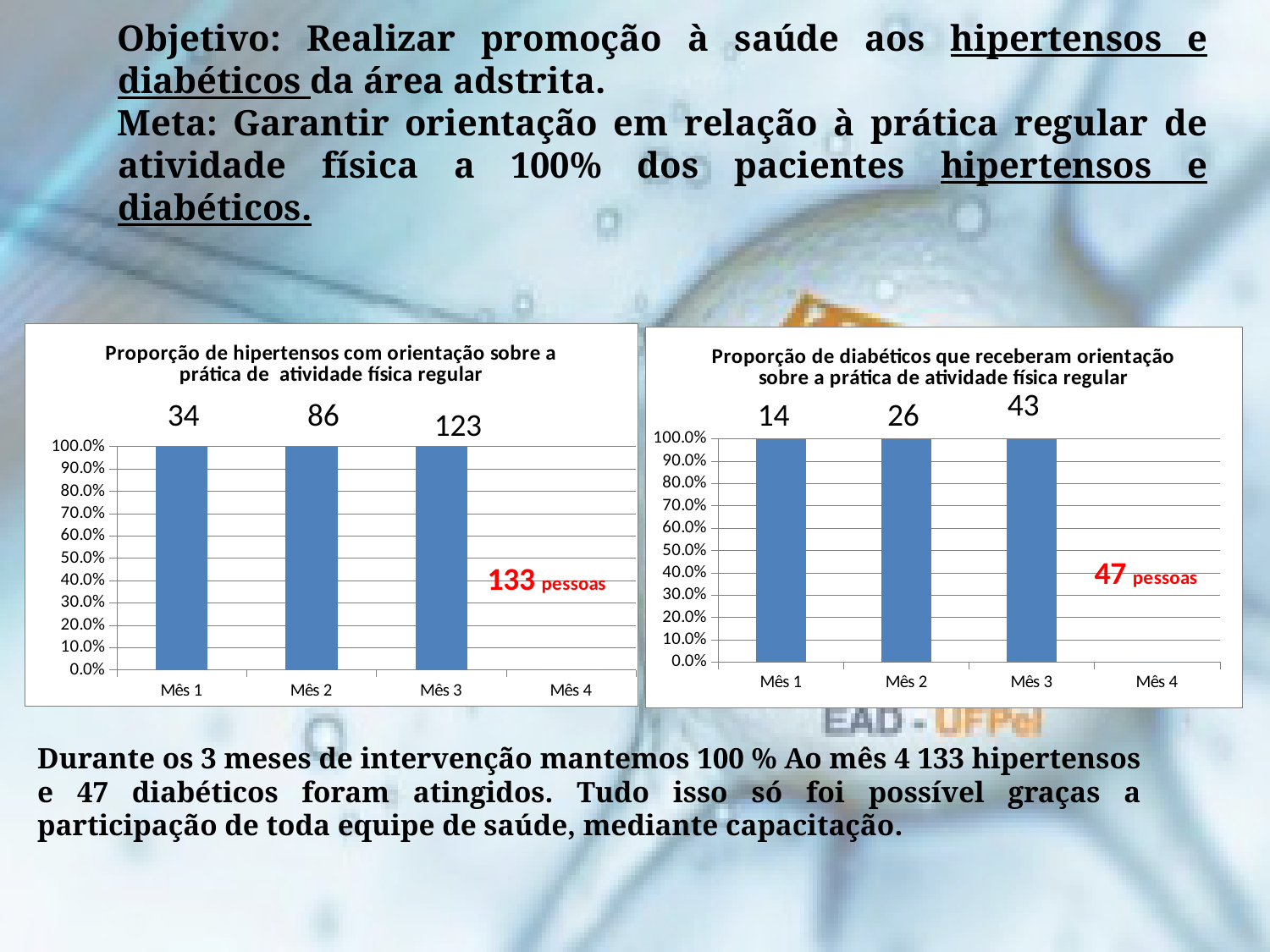
In the right chart (Proporção de diabéticos), do the numbers printed above the bars rise or fall from Mês 1 to Mês 3? Rise In the left chart (Proporção de hipertensos), what percentage does the bar for Mês 2 reach on the y axis? 100.0% In the left chart (Proporção de hipertensos), what is the difference between the numbers printed for Mês 3 and Mês 1? 89 In the right chart (Proporção de diabéticos), what number is printed above the bar for Mês 2? 26 In the right chart (Proporção de diabéticos), what number is printed above the bar for Mês 3? 43 What type of chart is the right chart (Proporção de diabéticos)? Bar chart In the left chart (Proporção de hipertensos), which month has the smallest number printed above its bar? Mês 1 How many month categories are shown on the x axis of the left chart (Proporção de hipertensos)? 4 In the left chart (Proporção de hipertensos), what number is printed above the bar for Mês 1? 34 In the right chart (Proporção de diabéticos), which month has the largest number printed above its bar? Mês 3 In the left chart (Proporção de hipertensos), what number is printed above the bar for Mês 3? 123 In the right chart (Proporção de diabéticos), what is the difference between the numbers printed for Mês 3 and Mês 1? 29